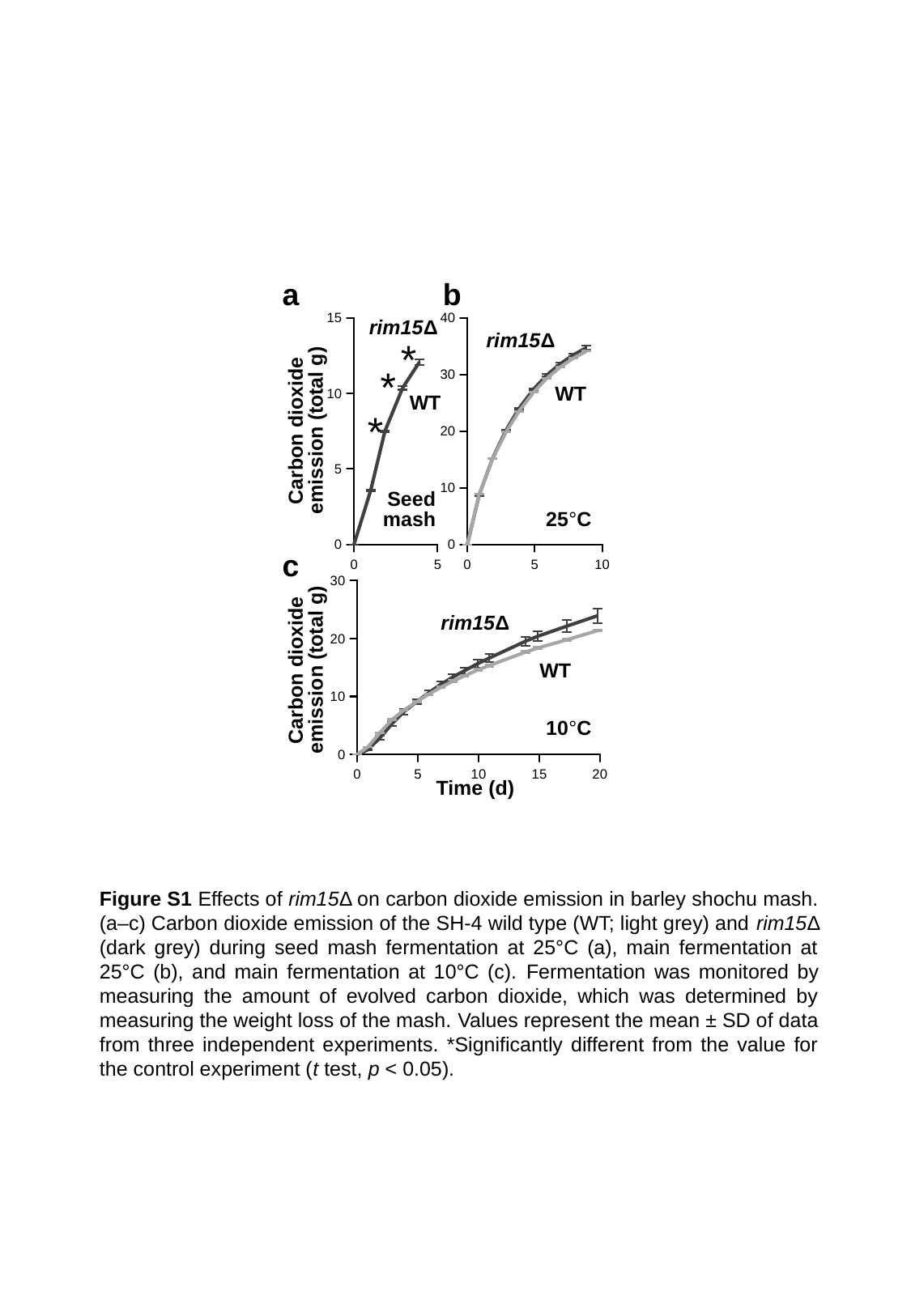
In panel b, is the carbon dioxide emission at day 1 greater or less than 10? less How many chart panels are shown on the slide? 3 In panel a, is the carbon dioxide emission at day 4 greater or less than 10? greater In panel a, is the carbon dioxide emission at day 1 greater or less than 5? less What is the x-axis label of panel c? Time (d) In panel b, do the carbon dioxide emission values rise or fall as time increases? rise What temperature is labelled on panel c? 10°C What kind of chart is panel a? line chart In panel c, how many series are plotted? 2 In panel c, at day 20, which series has the higher carbon dioxide emission, rim15Δ or WT? rim15Δ